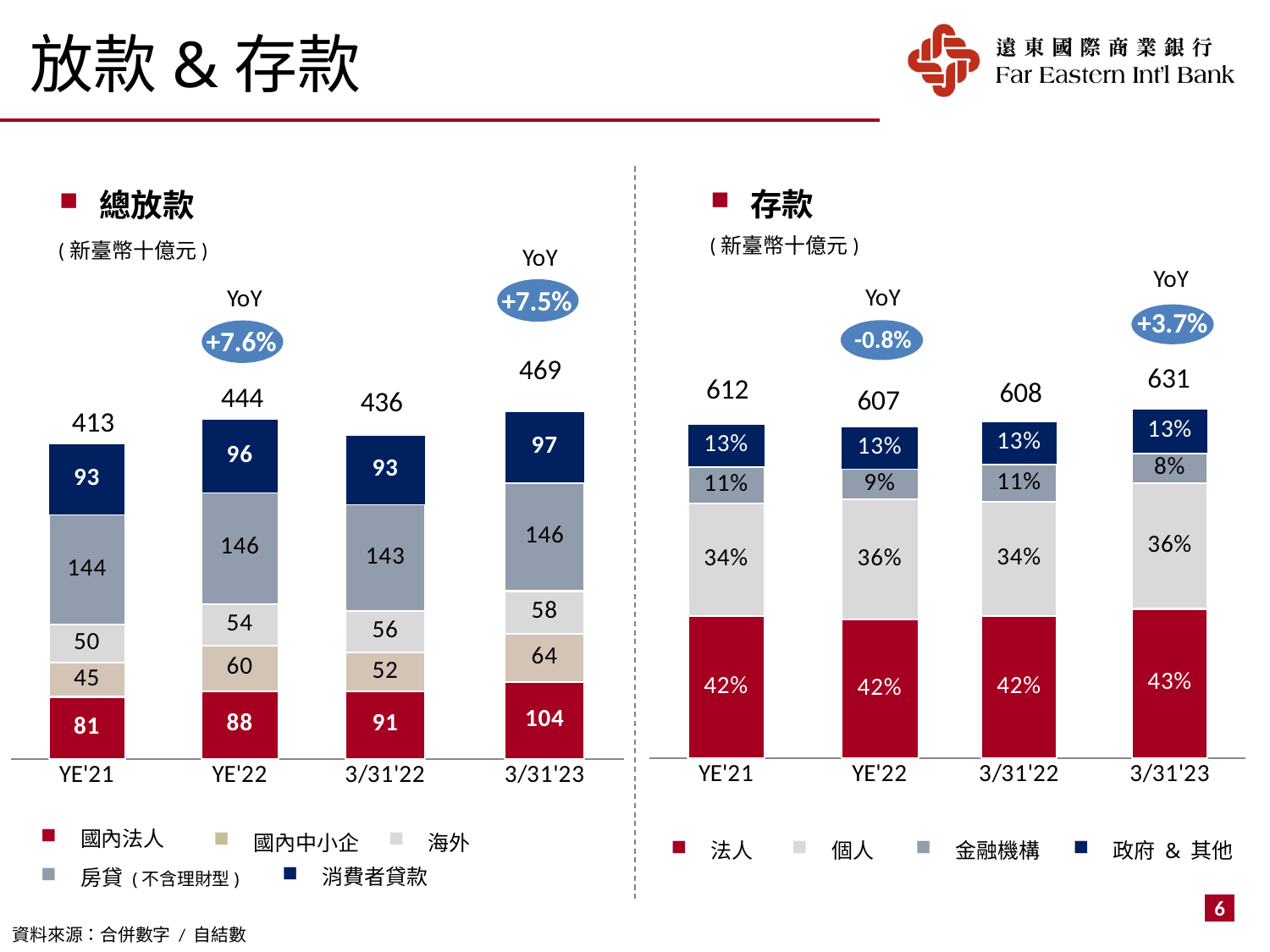
In the 總放款 chart on the left, how many series does the legend list? 5 In the 總放款 chart on the left, what YoY change is shown for 3/31'23? +7.5% In the 存款 chart on the right, what is the total deposit value for YE'22? 607 In the 總放款 chart on the left, which period has the lowest total? YE'21 In the 總放款 chart on the left, what is the total loan value for 3/31'23? 469 In the 總放款 chart on the left, which period has the highest total? 3/31'23 In the 存款 chart on the right, is the 金融機構 share larger at YE'21 or at 3/31'23? YE'21 In the 總放款 chart on the left, what is the difference between the 房貸 (不含理財型) values for YE'22 and YE'21? 2 In the 存款 chart on the right, how many periods are shown on the x axis? 4 In the 存款 chart on the right, what share of deposits is 個人 at 3/31'23? 36% What kind of chart is the 存款 chart on the right? Stacked bar chart In the 總放款 chart on the left, what is the 國內法人 value for YE'22? 88